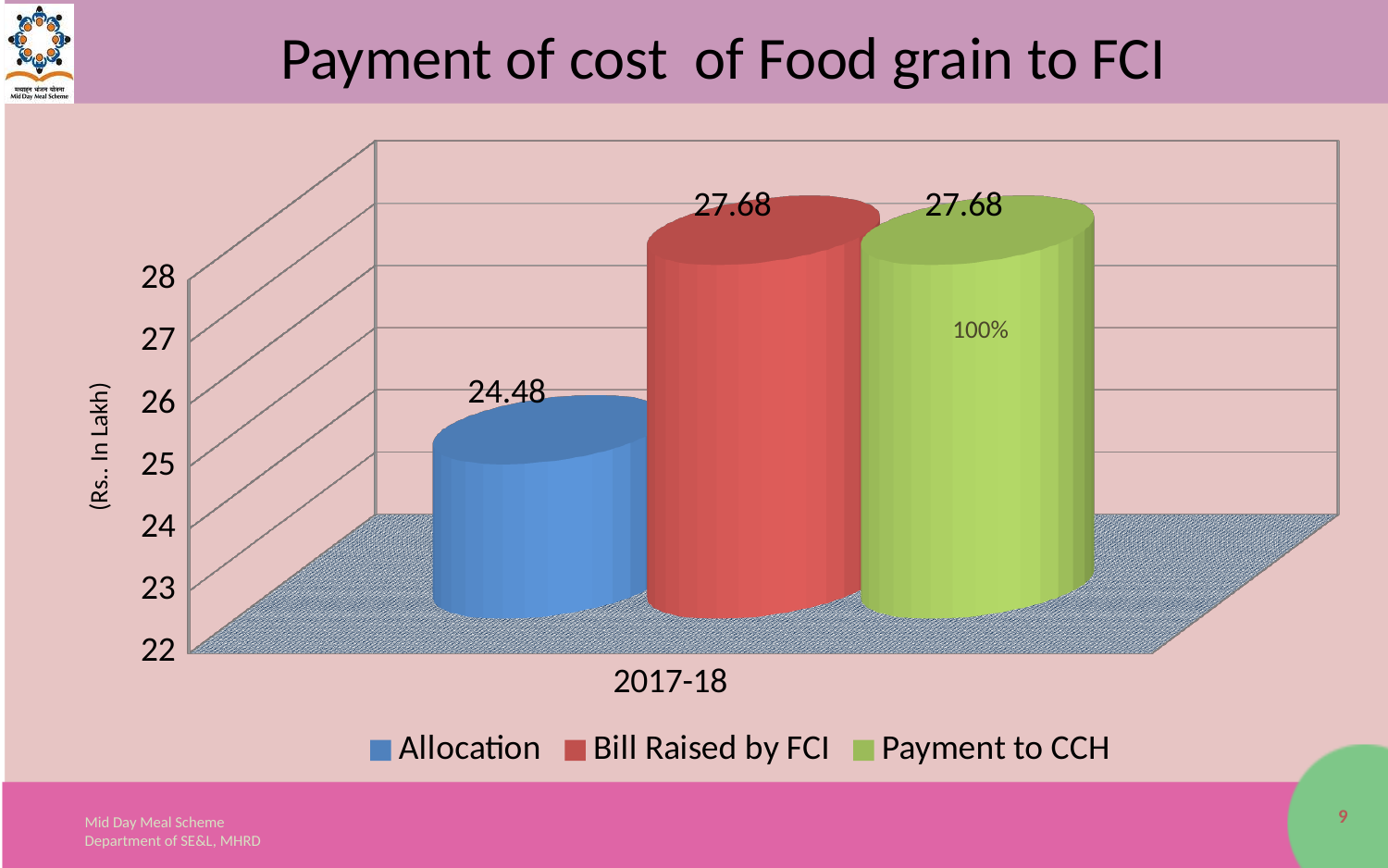
Which is larger in 2017-18, Allocation or Bill Raised by FCI? Bill Raised by FCI What kind of chart is shown on the slide? bar chart What is the value for Allocation in 2017-18? 24.48 Is the value for Allocation greater or less than 25? less What is the difference between Bill Raised by FCI and Allocation in 2017-18? 3.20 How many categories are shown on the x axis? 1 Is the value for Payment to CCH greater or less than 27? greater Which series has the lowest value in 2017-18? Allocation What is the value for Payment to CCH in 2017-18? 27.68 What is the value for Bill Raised by FCI in 2017-18? 27.68 What is the label on the vertical axis of the chart? (Rs.. In Lakh) How many series does the legend list? 3